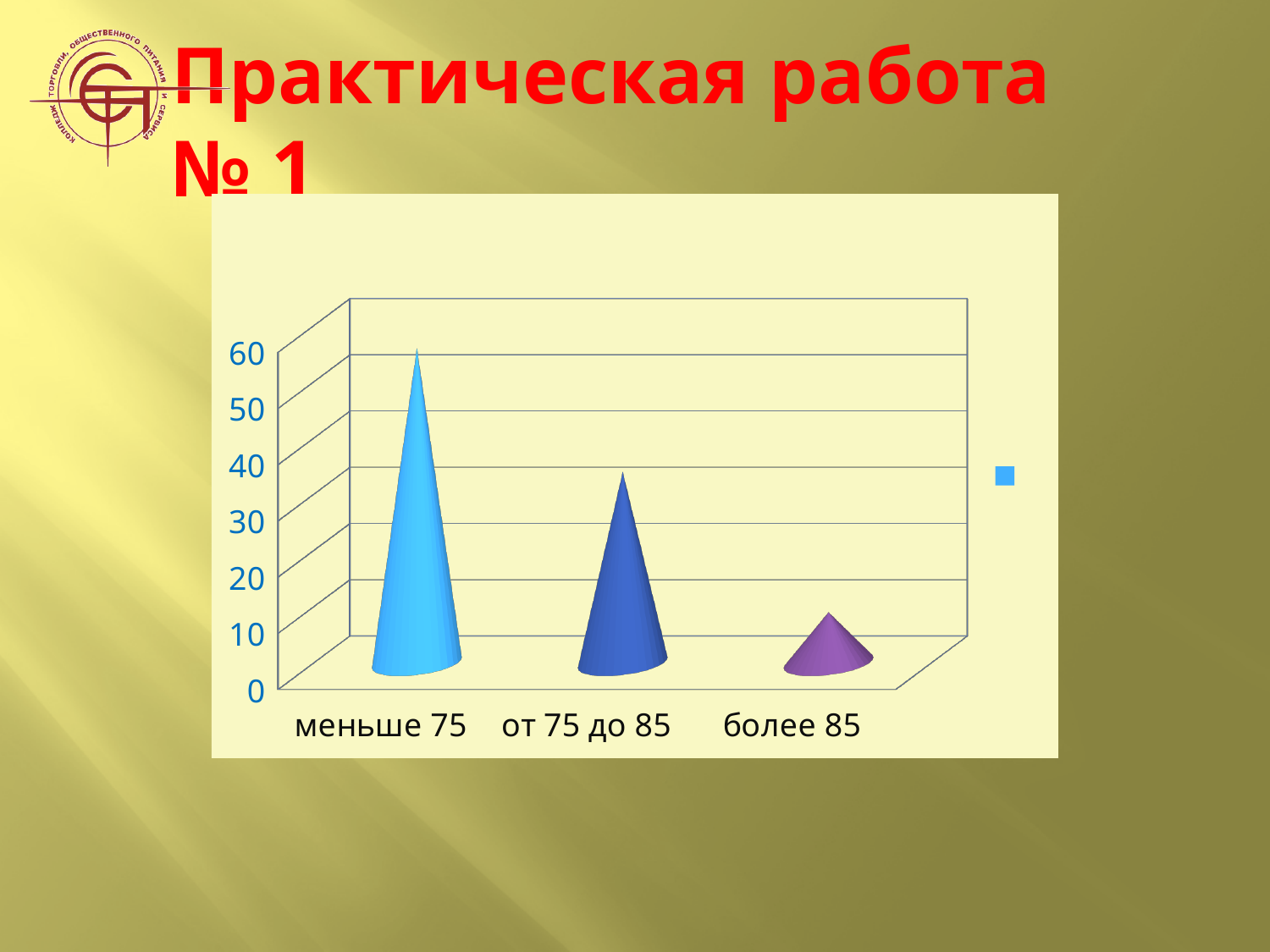
Which is larger, the value for "от 75 до 85" or the value for "более 85"? от 75 до 85 What kind of chart is shown on the slide? bar chart Which category has the highest value in the chart? меньше 75 How many series does the chart's legend list? 1 How many categories are shown on the x axis of the chart? 3 Is the value for "от 75 до 85" greater or less than 30? greater Do the values rise or fall moving from left to right along the x axis? fall Is the value for "более 85" greater or less than 20? less Is the value for "меньше 75" greater or less than 50? greater What is the highest tick value shown on the vertical axis of the chart? 60 Which category has the lowest value in the chart? более 85 Which is larger, the value for "меньше 75" or the value for "от 75 до 85"? меньше 75